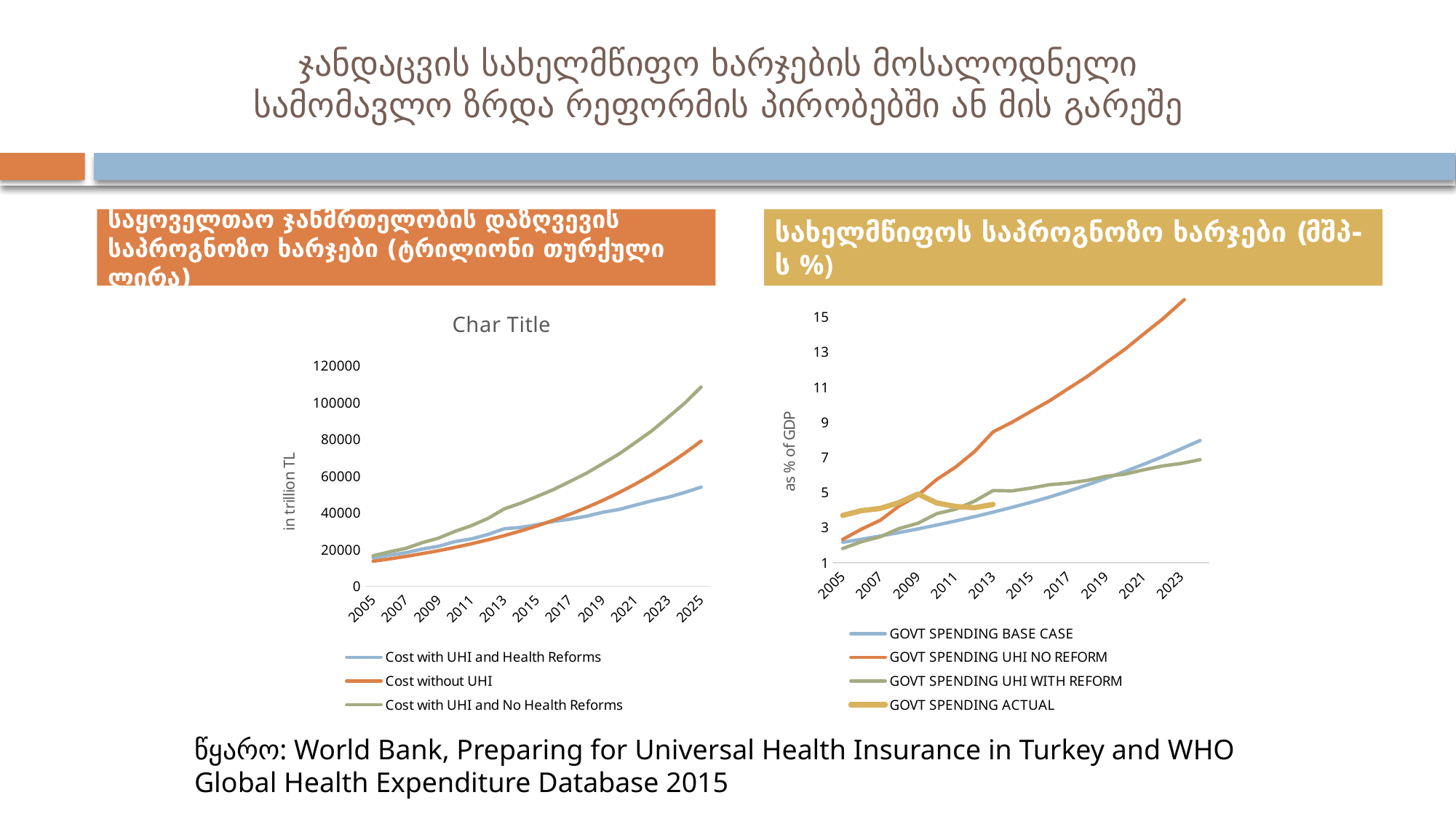
How many series does the legend of the right chart (as % of GDP) list? 4 In the right chart (as % of GDP), which series has the highest value in 2023? GOVT SPENDING UHI NO REFORM What is the y-axis label of the left chart ("Char Title")? in trillion TL In the right chart (as % of GDP), is the 2023 value for GOVT SPENDING BASE CASE greater or less than 7? greater In the left chart ("Char Title"), is the 2025 value for Cost with UHI and No Health Reforms greater or less than 100000? greater In the left chart ("Char Title"), is the 2025 value for Cost with UHI and Health Reforms greater or less than 60000? less In the right chart (as % of GDP), does the GOVT SPENDING UHI NO REFORM series rise or fall from 2005 to 2023? rise In the left chart ("Char Title"), which series has the highest value in 2025? Cost with UHI and No Health Reforms How many series does the legend of the left chart ("Char Title") list? 3 What type of chart is the left chart titled "Char Title"? line chart In the left chart ("Char Title"), which series has the lowest value in 2025? Cost with UHI and Health Reforms